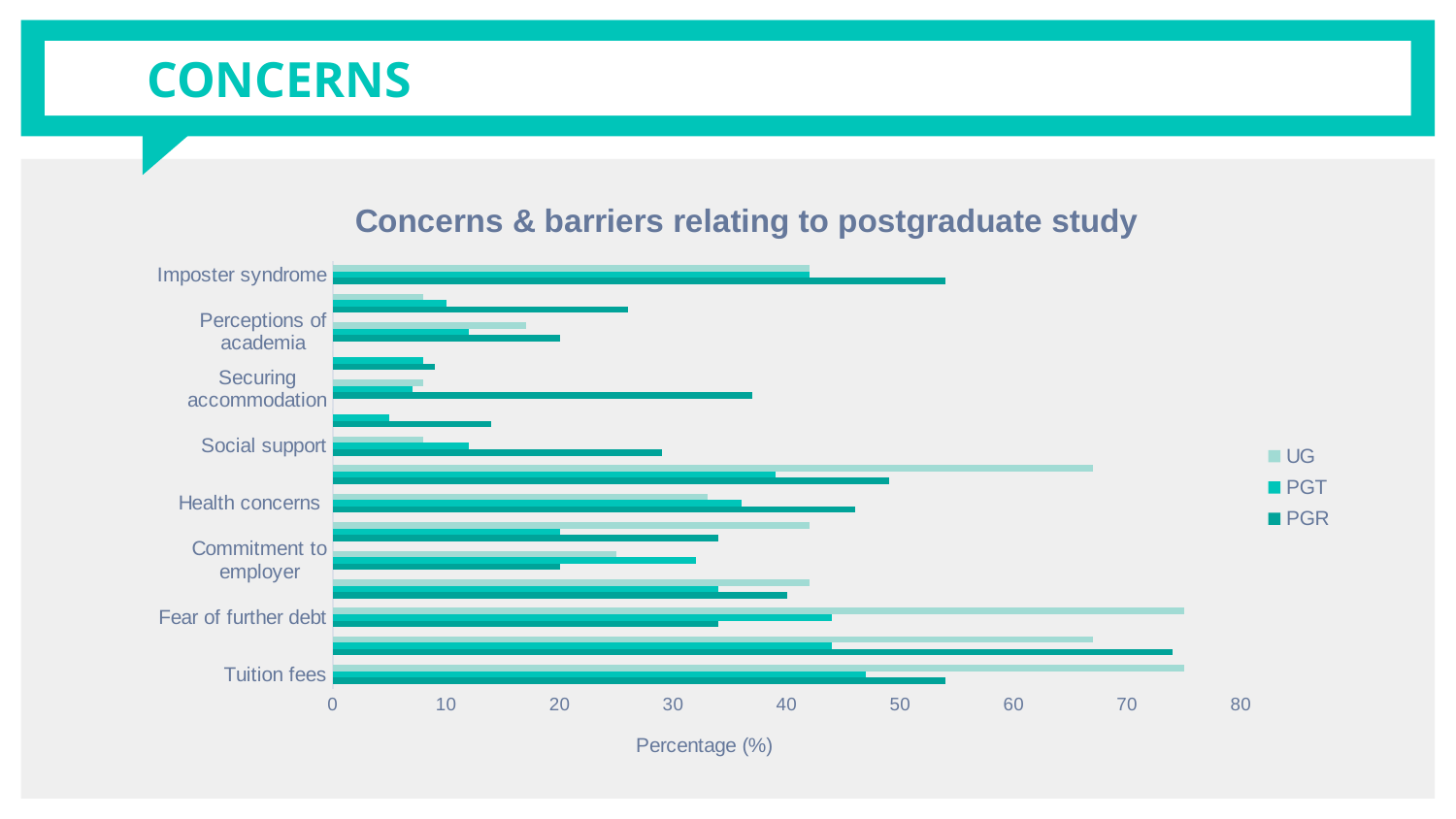
What kind of chart is shown on the slide? bar chart For Fear of further debt, which is larger: the UG value or the PGT value? UG What is the title of the chart? Concerns & barriers relating to postgraduate study Is the PGR value for Imposter syndrome greater or less than 50? greater How many series does the legend list? 3 For Tuition fees, which is larger: the UG value or the PGR value? UG What is the label of the horizontal axis? Percentage (%) For Imposter syndrome, which is larger: the UG value or the PGR value? PGR Is the PGR value for Tuition fees greater or less than 50? greater Is the PGR value for Health concerns greater or less than 40? greater